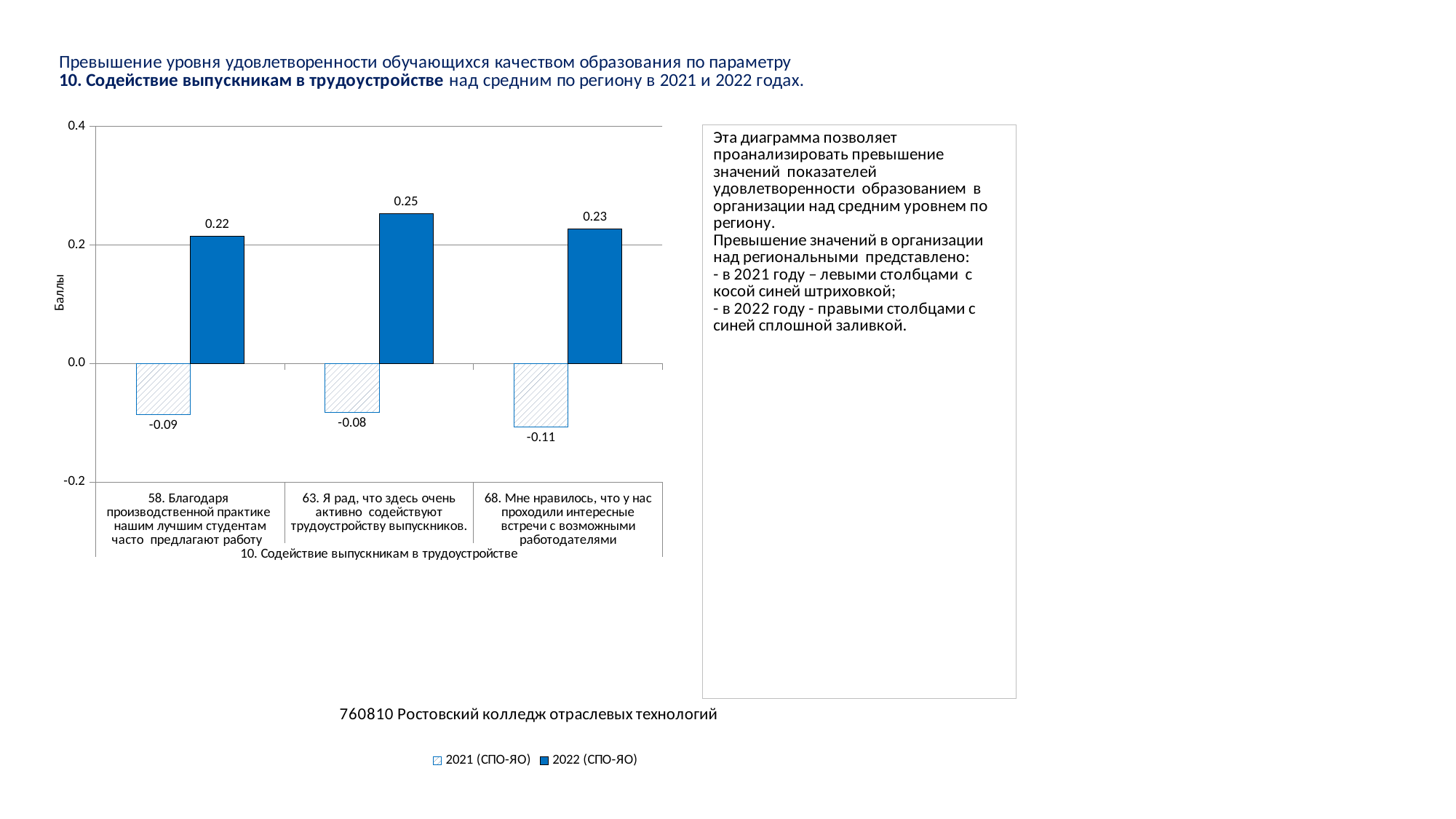
What kind of chart is shown on the slide? Bar chart How many series does the legend list? 2 What is the 2021 (СПО-ЯО) value for category 58 (Благодаря производственной практике нашим лучшим студентам часто предлагают работу)? -0.09 What is the 2022 (СПО-ЯО) value for category 63 (Я рад, что здесь очень активно содействуют трудоустройству выпускников)? 0.25 Is the 2022 value for category 63 greater or less than 0.2? greater What is the label of the vertical axis? Баллы Which category has the highest 2022 (СПО-ЯО) value? 63. Я рад, что здесь очень активно содействуют трудоустройству выпускников. What is the 2021 (СПО-ЯО) value for category 68 (Мне нравилось, что у нас проходили интересные встречи с возможными работодателями)? -0.11 How many categories are shown on the x axis? 3 Which category has the lowest 2021 (СПО-ЯО) value? 68. Мне нравилось, что у нас проходили интересные встречи с возможными работодателями Which is larger: the 2022 value for category 58 or the 2022 value for category 68? 2022 value for category 68 What is the difference between the 2022 and 2021 values for category 58? 0.31